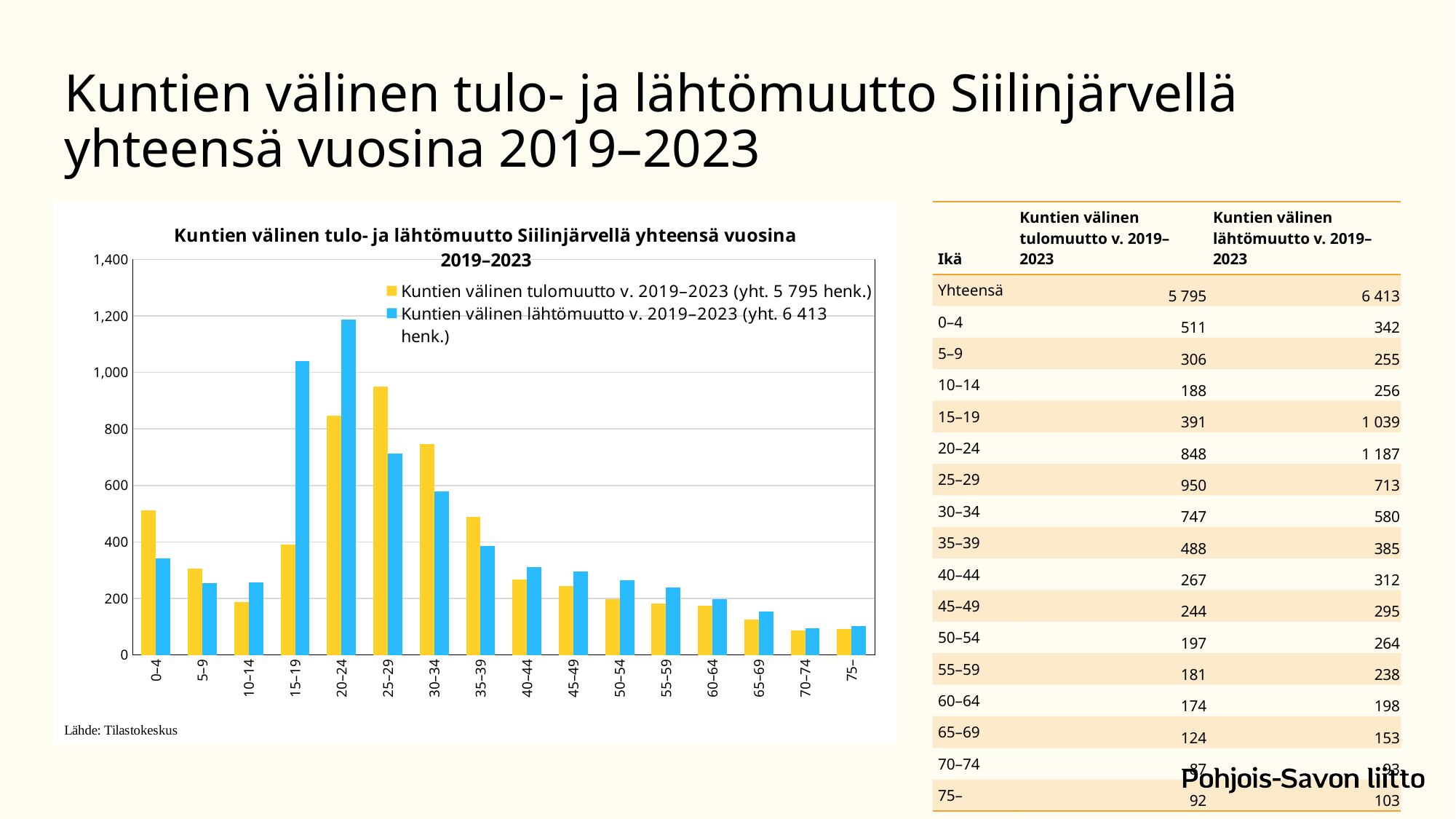
Do the tulomuutto values rise or fall along the x axis from the 25–29 age group to the 75– age group? fall What is the value of Kuntien välinen lähtömuutto v. 2019–2023 for the 15–19 age group? 1 039 Which age group has the highest value for Kuntien välinen tulomuutto v. 2019–2023? 25–29 Is the value for Kuntien välinen lähtömuutto in the 20–24 age group greater or less than 1,000? greater How many series does the chart's legend list? 2 Which age group has the highest value for Kuntien välinen lähtömuutto v. 2019–2023? 20–24 For the 0–4 age group, which is larger: tulomuutto or lähtömuutto? tulomuutto What is the difference between lähtömuutto and tulomuutto for the 20–24 age group? 339 What is the value of Kuntien välinen tulomuutto v. 2019–2023 for the 0–4 age group? 511 How many age groups are shown on the x axis of the chart? 16 What kind of chart is shown on the slide? bar chart According to the legend, what is the total number of people for Kuntien välinen tulomuutto v. 2019–2023? 5 795 henk.